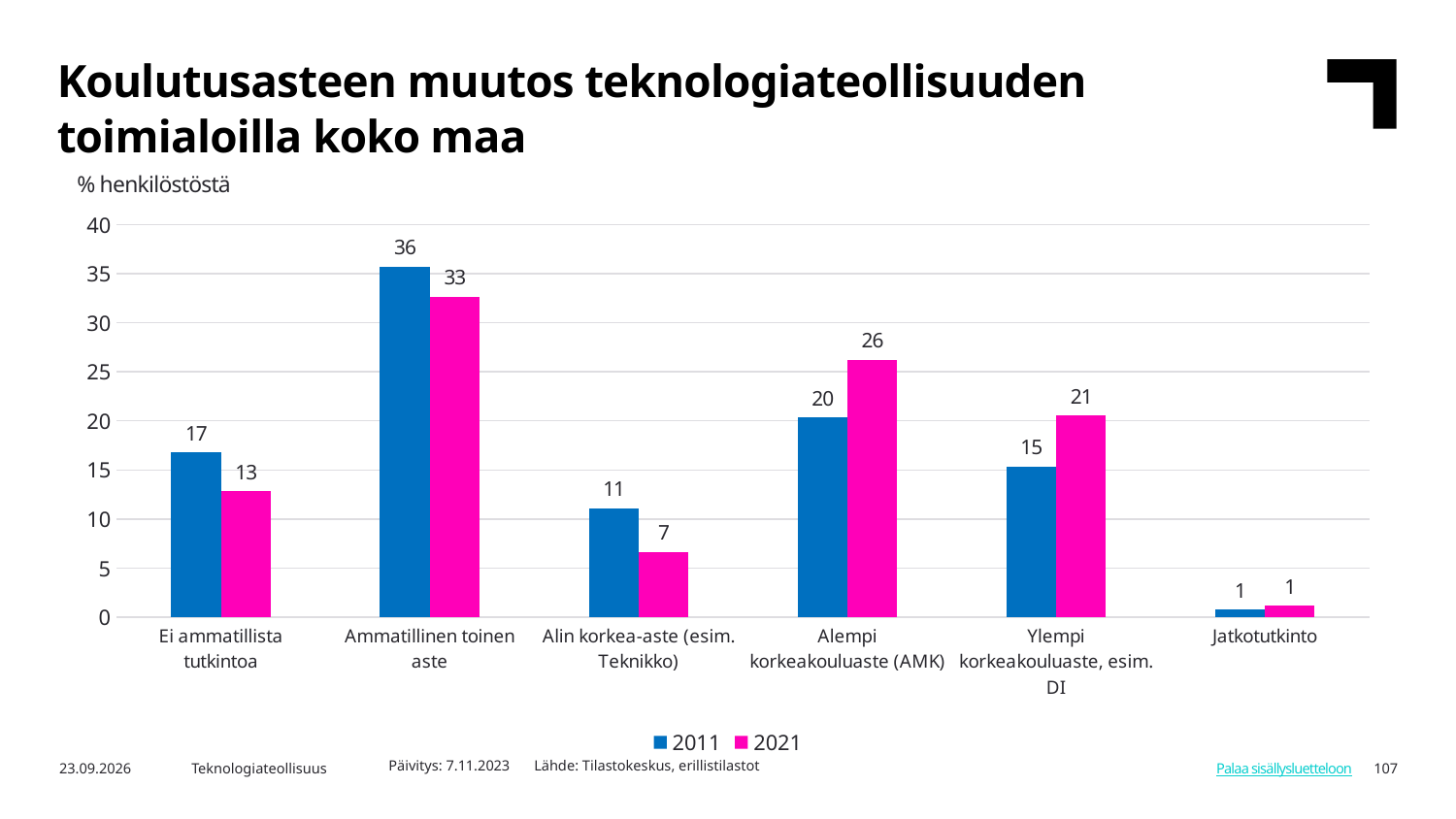
What unit is indicated above the chart's y axis? % henkilöstöstä Which category has the lowest value for 2021? Jatkotutkinto What kind of chart is shown on the slide? Bar chart Which is larger for "Ylempi korkeakouluaste, esim. DI": the 2011 value or the 2021 value? 2021 Is the 2021 value for "Ammatillinen toinen aste" greater or less than 30? greater Which category has the highest value for 2011? Ammatillinen toinen aste What is the value for 2021 in the "Alempi korkeakouluaste (AMK)" category? 26 What is the value for 2011 in the "Ammatillinen toinen aste" category? 36 What is the difference between the 2011 and 2021 values for "Alin korkea-aste (esim. Teknikko)"? 4 What is the value for 2021 in the "Ei ammatillista tutkintoa" category? 13 How many series does the legend list? 2 How many categories are shown on the x axis? 6